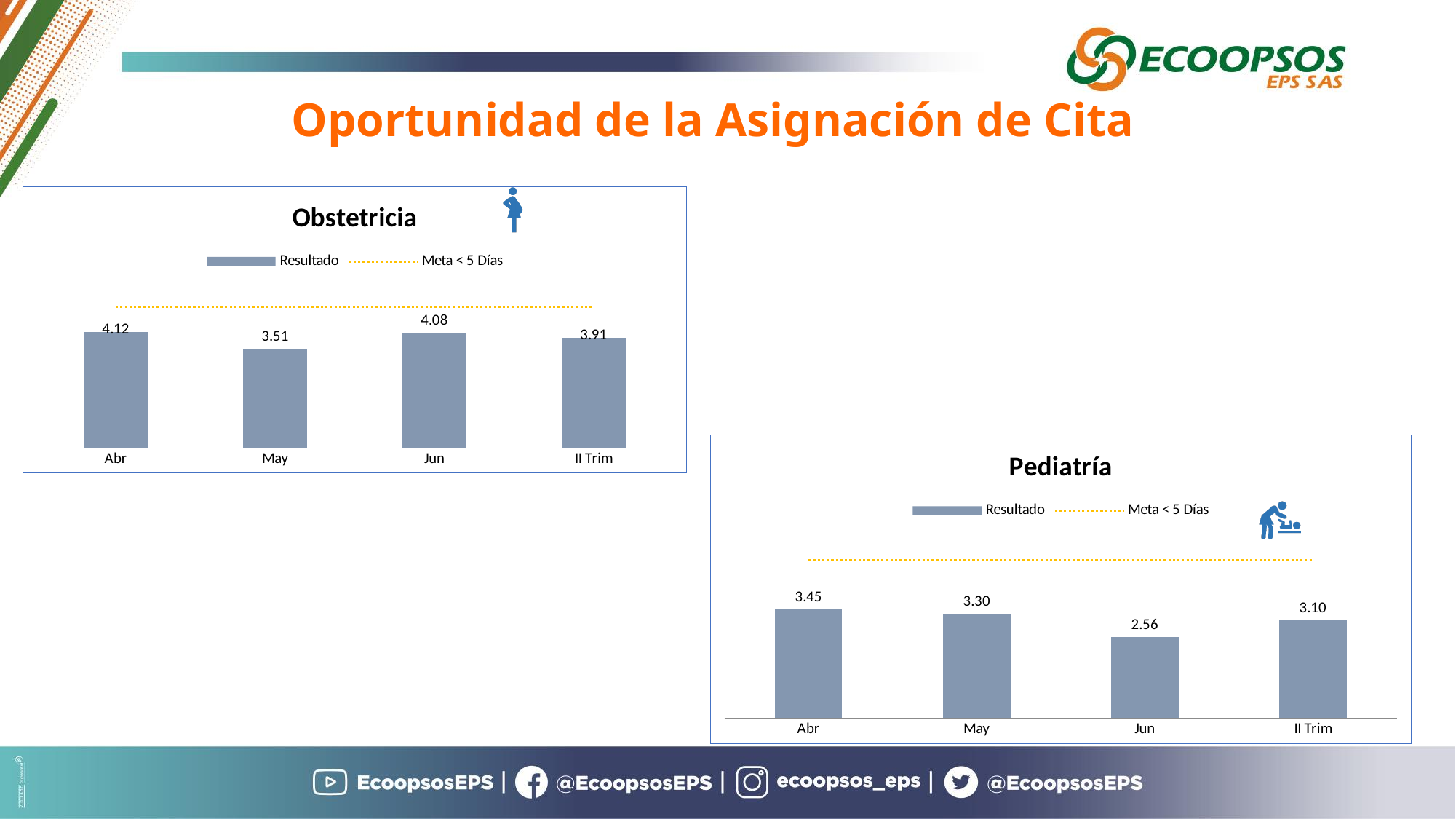
How many entries does the legend of the Obstetricia chart list? 2 In the Pediatría chart, what is the difference between the Resultado values for Abr and Jun? 0.89 In the Pediatría chart, which month has the highest Resultado value? Abr In the Obstetricia chart, what is the Resultado value for Abr? 4.12 In the Obstetricia chart, what is the difference between the Resultado values for Abr and May? 0.61 In the Pediatría chart, which is larger, the Resultado value for May or for Jun? May In the Pediatría chart, what is the Resultado value for Jun? 2.56 In the Obstetricia chart, what is the Resultado value for II Trim? 3.91 In the Pediatría chart, what is the Resultado value for II Trim? 3.10 In the Obstetricia chart, how many categories are shown on the x axis? 4 What kind of chart is the Pediatría chart? Bar chart In the Obstetricia chart, which month has the lowest Resultado value? May